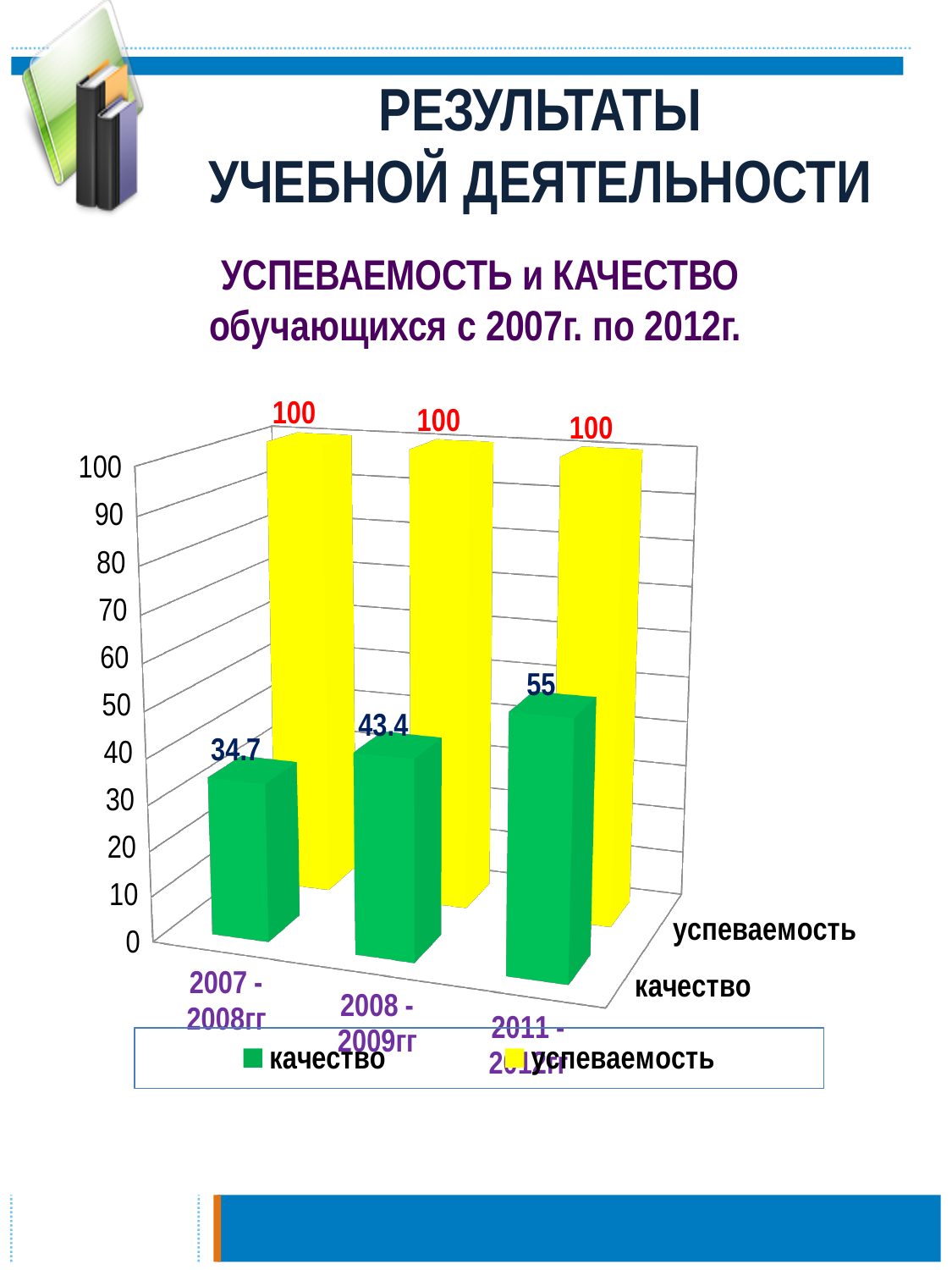
Which period has the highest value of качество? 2011 - 2012гг Which period has the lowest value of качество? 2007 - 2008гг How many series does the legend list? 2 What is the value of успеваемость for 2008 - 2009гг? 100 What is the value of качество for 2007 - 2008гг? 34.7 What is the value of качество for 2008 - 2009гг? 43.4 How many periods are shown on the x axis? 3 Which is larger for 2008 - 2009гг: качество or успеваемость? успеваемость What kind of chart is shown on the slide? bar chart What is the difference between качество in 2011 - 2012гг and in 2007 - 2008гг? 20.3 What is the value of качество for 2011 - 2012гг? 55 Does the value of качество rise or fall from 2007 - 2008гг to 2011 - 2012гг? rise